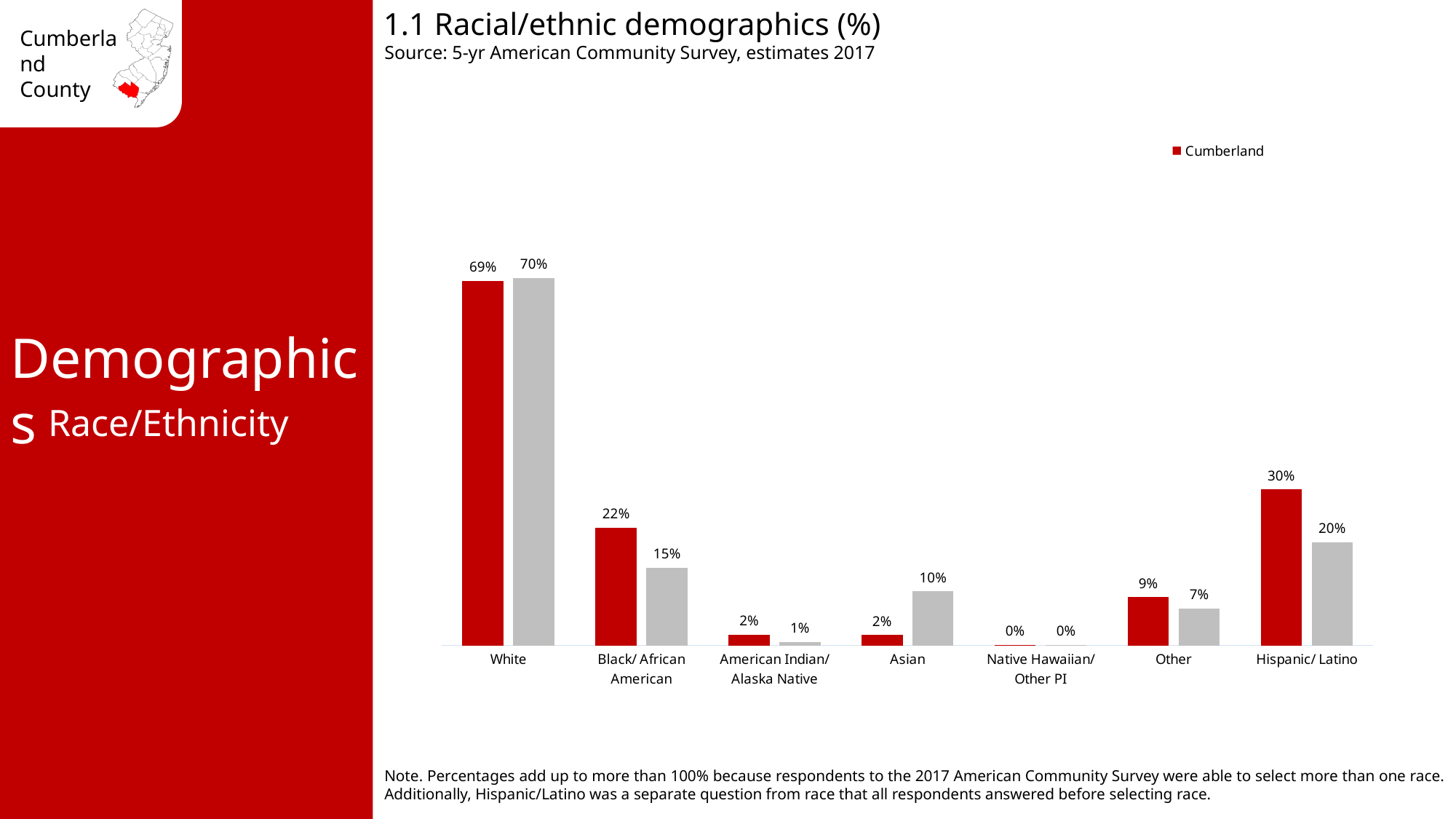
What kind of chart is shown on the slide? Bar chart Which category has the highest Cumberland value? White Which is larger for Cumberland: Hispanic/ Latino or Black/ African American? Hispanic/ Latino How many categories are shown on the x axis? 7 What is the Cumberland value for Other? 9% What is the difference between the Cumberland values for White and Hispanic/ Latino? 39% What is the Cumberland value for White? 69% What is the Cumberland value for Hispanic/ Latino? 30% What is the difference between the Cumberland values for Black/ African American and Other? 13% How many series does the legend list? 1 What is the Cumberland value for Black/ African American? 22% Which category has the lowest Cumberland value? Native Hawaiian/ Other PI